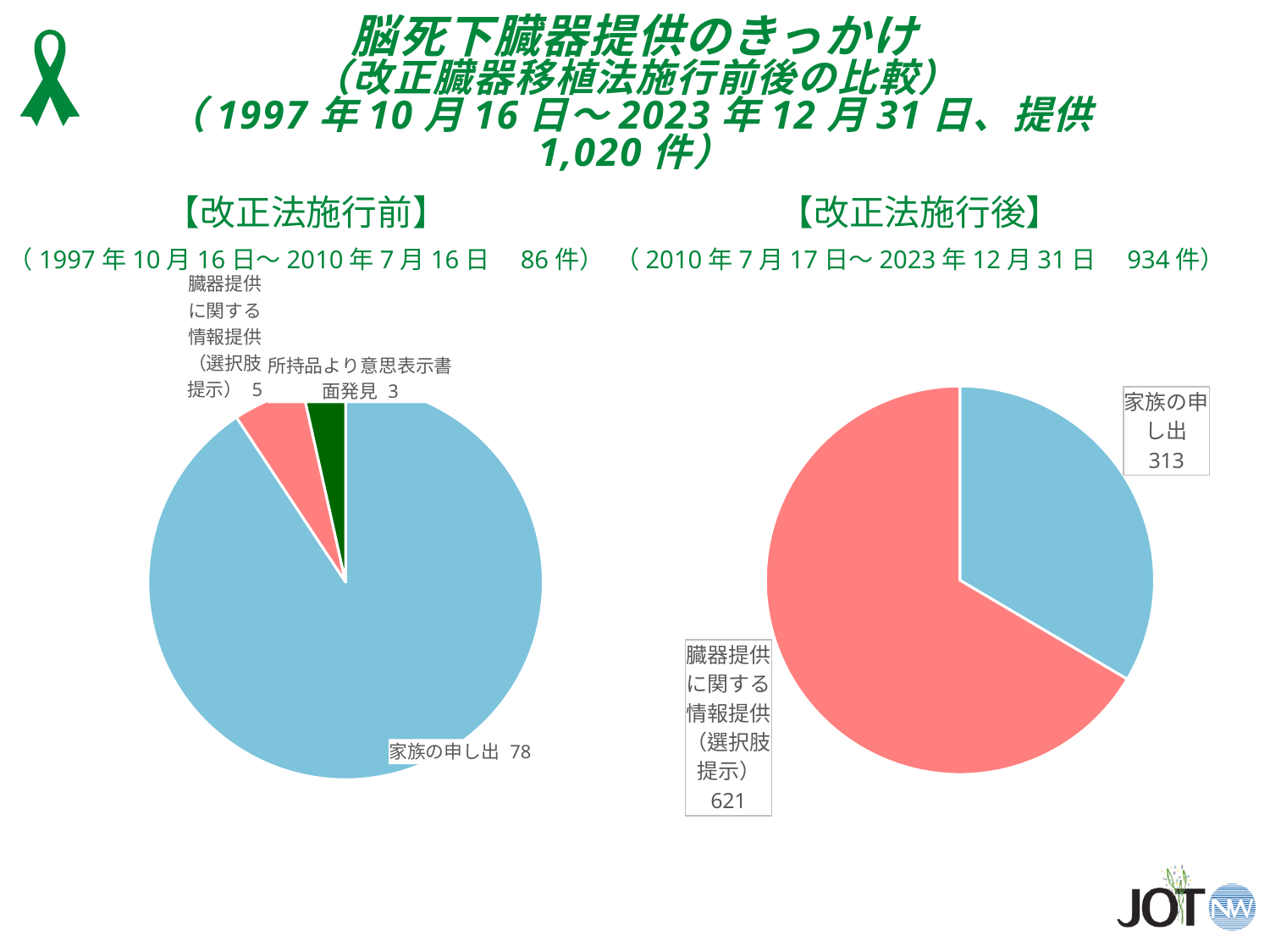
In the right pie chart (改正法施行後), what is the value for 家族の申し出? 313 In the right pie chart (改正法施行後), which category has the larger slice? 臓器提供に関する情報提供（選択肢提示） In the right pie chart (改正法施行後), what is the value for 臓器提供に関する情報提供（選択肢提示）? 621 How many categories does the right pie chart (改正法施行後) show? 2 What type of chart is used on this slide? Pie chart In the left pie chart (改正法施行前), which category has the smallest slice? 所持品より意思表示書面発見 In the left pie chart (改正法施行前), what is the value for 所持品より意思表示書面発見? 3 In the left pie chart (改正法施行前), which category has the largest slice? 家族の申し出 In the left pie chart (改正法施行前), what is the difference between 家族の申し出 and 臓器提供に関する情報提供（選択肢提示）? 73 How many categories does the left pie chart (改正法施行前) show? 3 In the left pie chart (改正法施行前), what is the value for 家族の申し出? 78 In the right pie chart (改正法施行後), what is the difference between 臓器提供に関する情報提供（選択肢提示） and 家族の申し出? 308